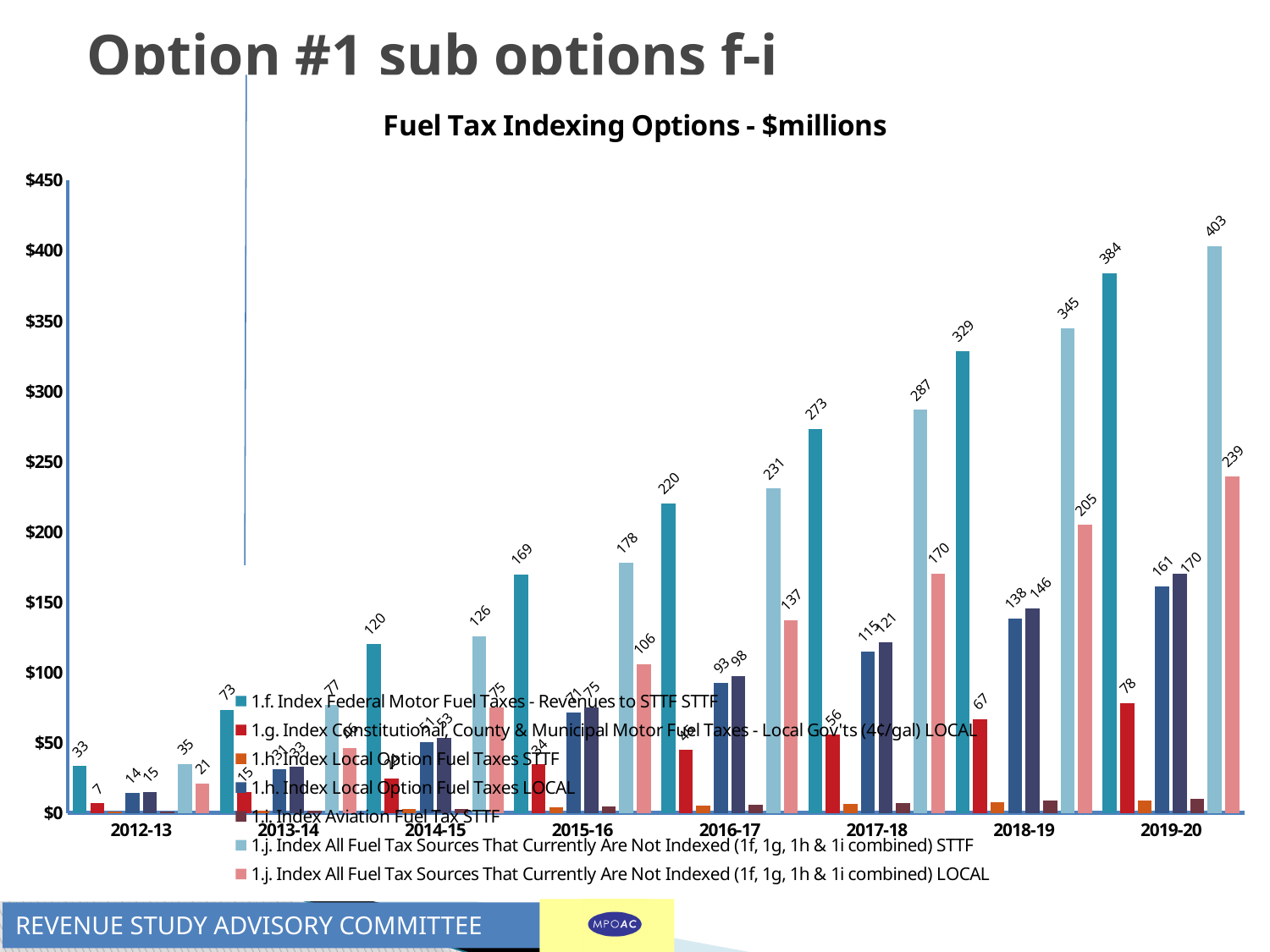
What kind of chart is shown on the slide? bar chart What is the value for 1.j. Index All Fuel Tax Sources That Currently Are Not Indexed LOCAL in 2019-20? 239 What is the difference between the 1.j. Index All Fuel Tax Sources STTF value and the 1.f. Index Federal Motor Fuel Taxes STTF value in 2019-20? 19 In which year is the 1.f. Index Federal Motor Fuel Taxes - Revenues to STTF value highest? 2019-20 What is the value for 1.f. Index Federal Motor Fuel Taxes - Revenues to STTF in 2012-13? 33 What is the value for 1.f. Index Federal Motor Fuel Taxes - Revenues to STTF in 2019-20? 384 What is the title of the chart? Fuel Tax Indexing Options - $millions In 2019-20, which is larger: the 1.j. Index All Fuel Tax Sources STTF value or the 1.f. Index Federal Motor Fuel Taxes STTF value? 1.j. Index All Fuel Tax Sources STTF Do the values for 1.f. Index Federal Motor Fuel Taxes - Revenues to STTF rise or fall from 2012-13 to 2019-20? rise How many fiscal-year categories are shown on the x axis? 8 What is the value for 1.j. Index All Fuel Tax Sources That Currently Are Not Indexed STTF in 2019-20? 403 In which year is the 1.j. Index All Fuel Tax Sources STTF value lowest? 2012-13